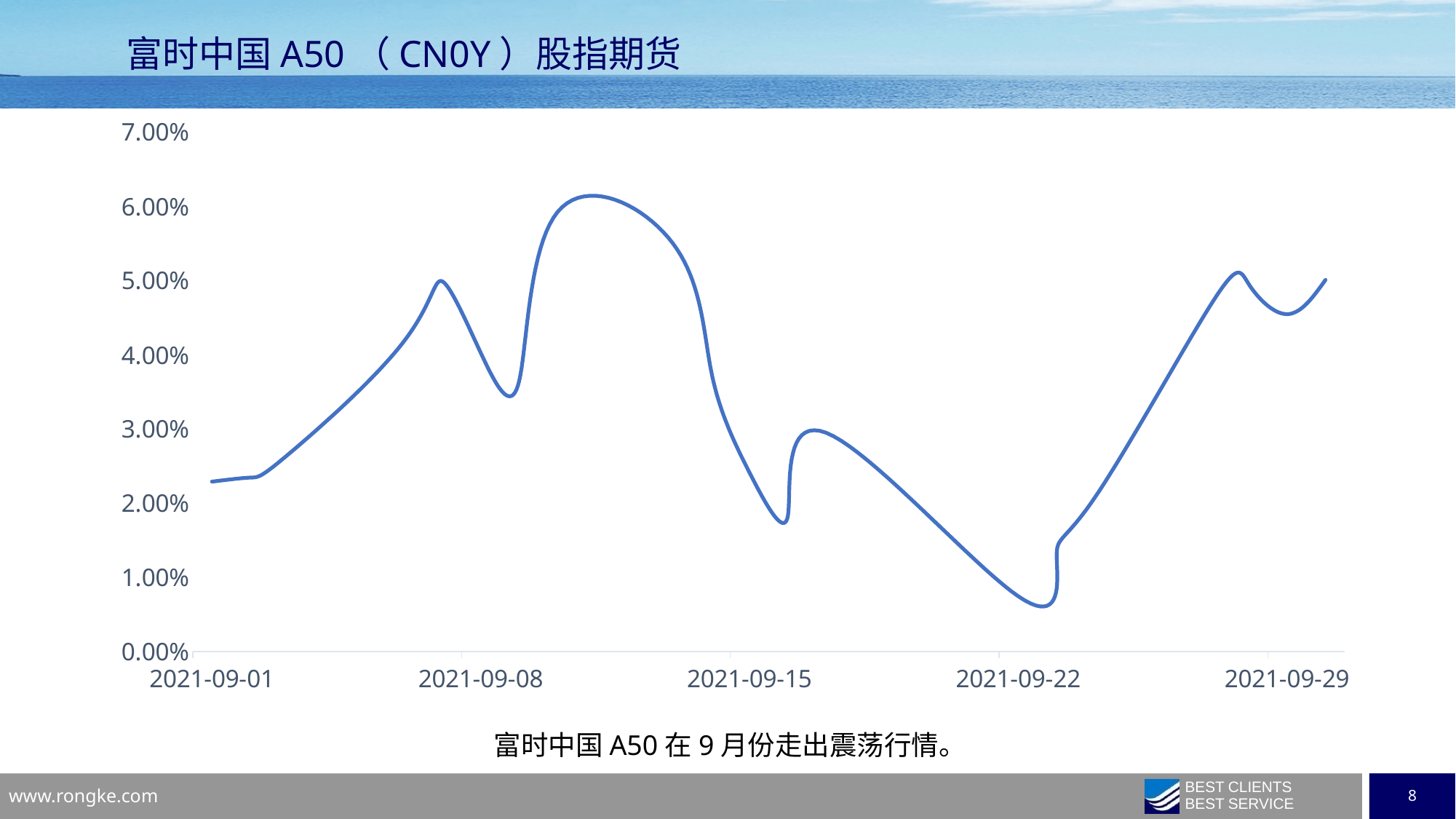
What kind of chart is shown on the slide? line chart How many date labels are shown on the x axis? 5 Is the value on 2021-09-01 greater or less than 3.00%? less Which date has the larger value, 2021-09-08 or 2021-09-22? 2021-09-08 What is the title of the chart? 富时中国 A50 （CN0Y） 股指期货 Is the value at the end of the series (2021-09-29) higher or lower than at the start (2021-09-01)? higher Is the value on 2021-09-29 greater or less than 4.00%? greater Is the value on 2021-09-08 greater or less than 3.00%? greater